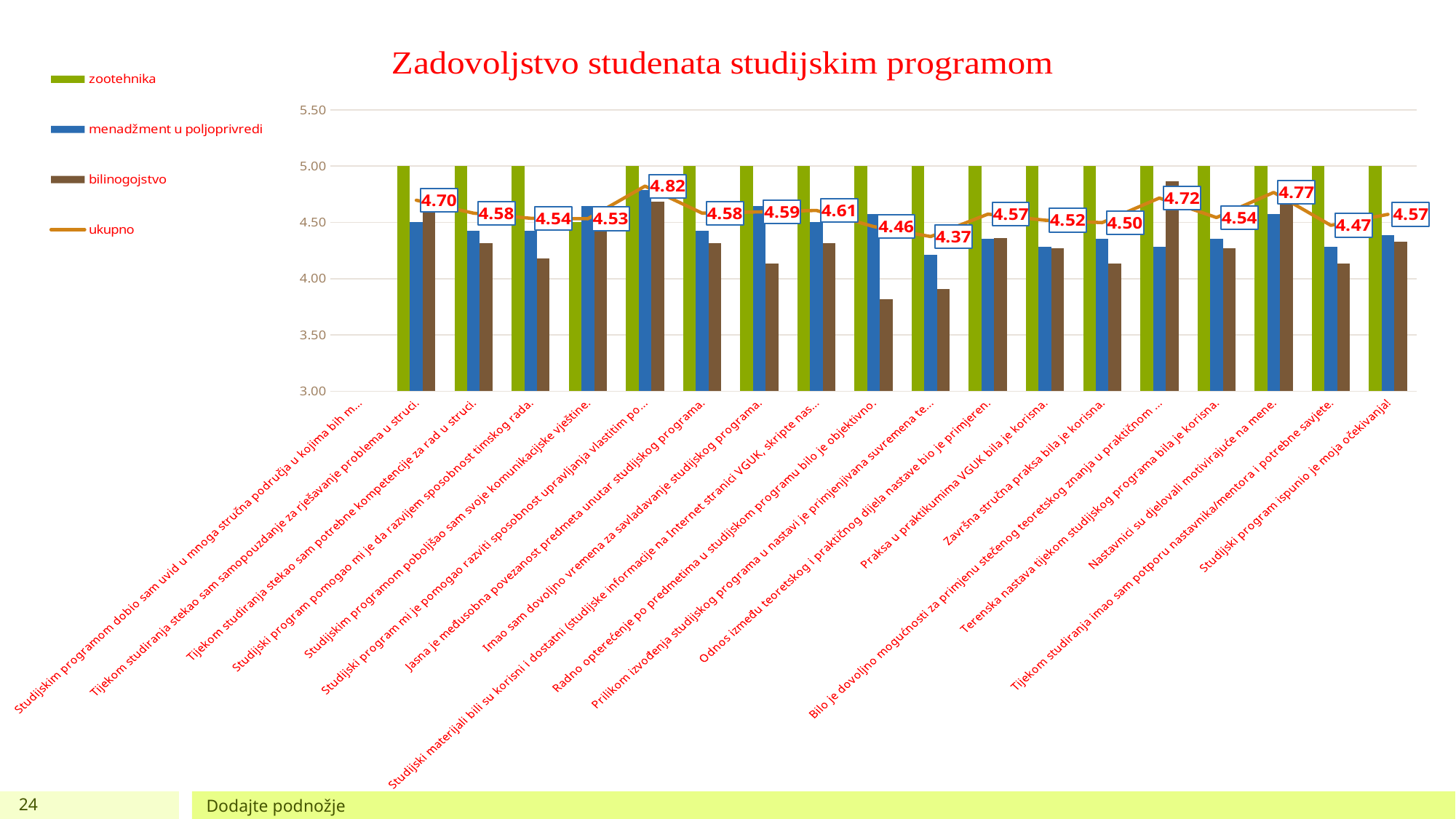
What is the title of the chart? Zadovoljstvo studenata studijskim programom What is the difference between the highest and lowest ukupno values? 0.45 What is the ukupno value for 'Studijski program ispunio je moja očekivanja!'? 4.57 How many series does the legend list? 4 Which is larger, the ukupno value for 'Tijekom studiranja stekao sam samopouzdanje za rješavanje problema u struci.' or for 'Tijekom studiranja stekao sam potrebne kompetencije za rad u struci.'? Tijekom studiranja stekao sam samopouzdanje za rješavanje problema u struci. Which category has the highest ukupno value? Studijski program mi je pomogao razviti sposobnost upravljanja vlastitim po... What is the ukupno value for 'Nastavnici su djelovali motivirajuće na mene.'? 4.77 What is the ukupno value for 'Studijski program mi je pomogao razviti sposobnost upravljanja vlastitim po...'? 4.82 What is the ukupno value for 'Prilikom izvođenja studijskog programa u nastavi je primjenjivana suvremena te...'? 4.37 Which category has the lowest ukupno value? Prilikom izvođenja studijskog programa u nastavi je primjenjivana suvremena te... What kind of chart is this? Combined bar and line chart Is the bilinogojstvo value for 'Radno opterećenje po predmetima u studijskom programu bilo je objektivno.' greater or less than 4.00? less